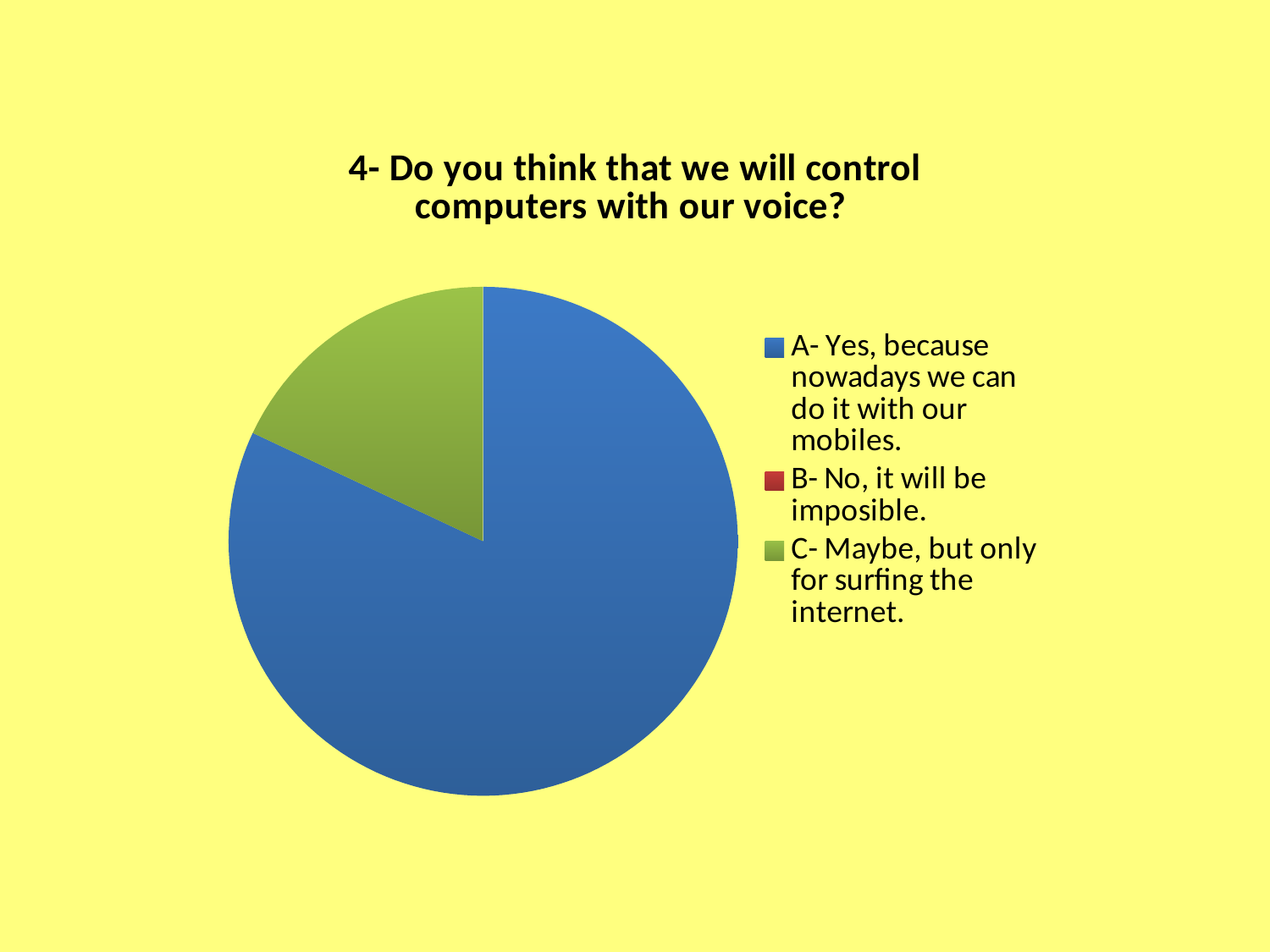
What is the title of the chart? 4- Do you think that we will control computers with our voice? How many entries does the chart's legend list? 3 Does the slice for option C (Maybe, but only for surfing the internet) take up more or less than half of the pie? less What kind of chart is shown on the slide? pie chart Does the slice for option A (Yes) take up more or less than half of the pie? more Which answer option has the largest slice of the pie? A- Yes, because nowadays we can do it with our mobiles. Which colour represents option C (Maybe, but only for surfing the internet) in the pie chart? green Which slice is larger: option A (Yes) or option C (Maybe, but only for surfing the internet)? A- Yes, because nowadays we can do it with our mobiles.